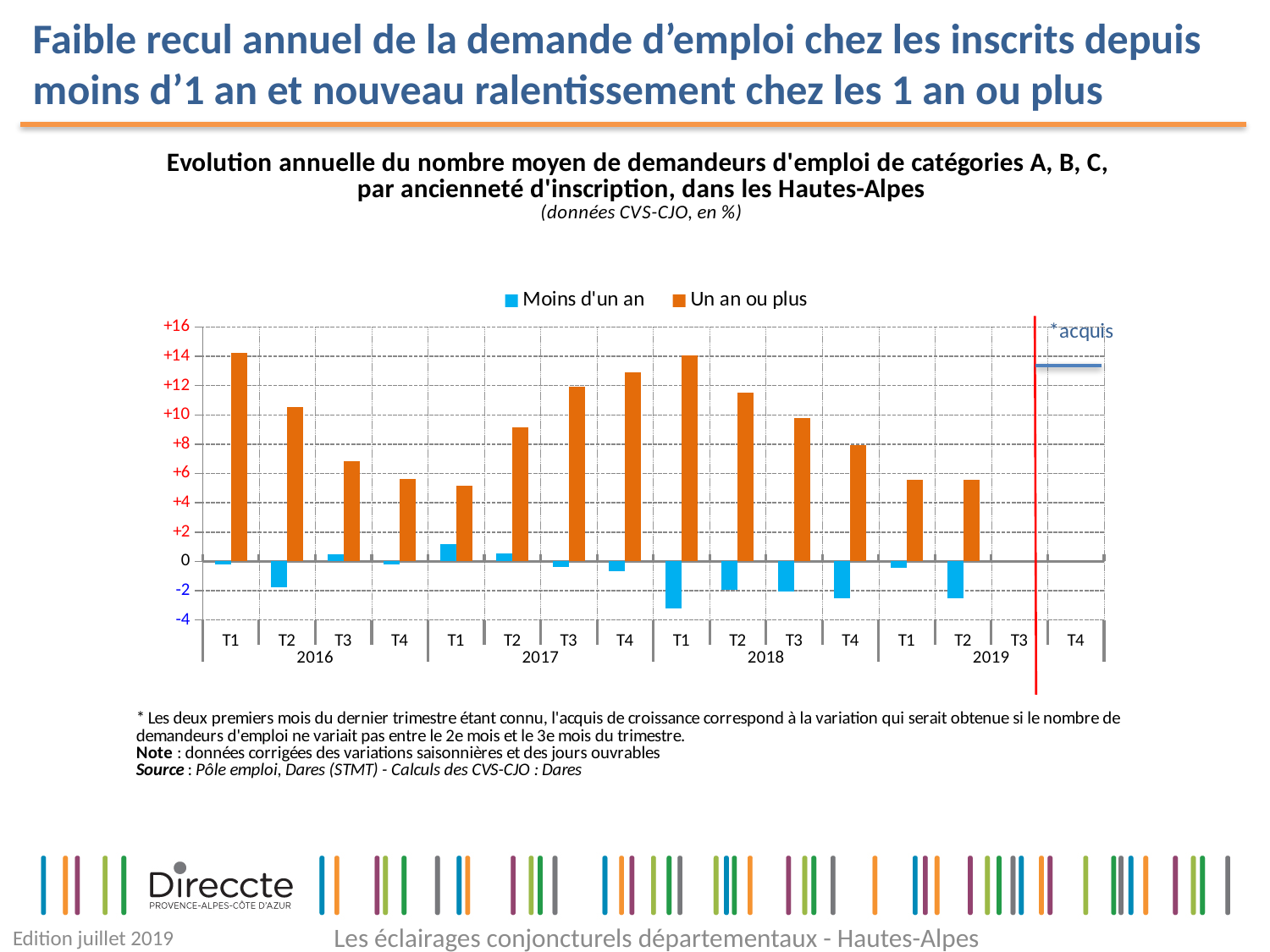
Does the value for "Un an ou plus" rise or fall from T1 2018 to T1 2019? Fall Is the value for "Moins d'un an" in T1 2018 greater or less than -2? less Does the value for "Un an ou plus" rise or fall from T1 2016 to T1 2017? Fall Which quarter has the highest value for "Moins d'un an"? T1 2017 Which quarter has the lowest value for "Moins d'un an"? T1 2018 Is the value for "Un an ou plus" in T1 2016 greater or less than +12? greater What kind of chart is shown on the slide? Bar chart Which colour represents the series "Un an ou plus" in the legend? Orange How many series does the legend list? 2 Is the value for "Un an ou plus" in T4 2018 greater or less than +10? less For "Un an ou plus", which is larger: T2 2016 or T3 2016? T2 2016